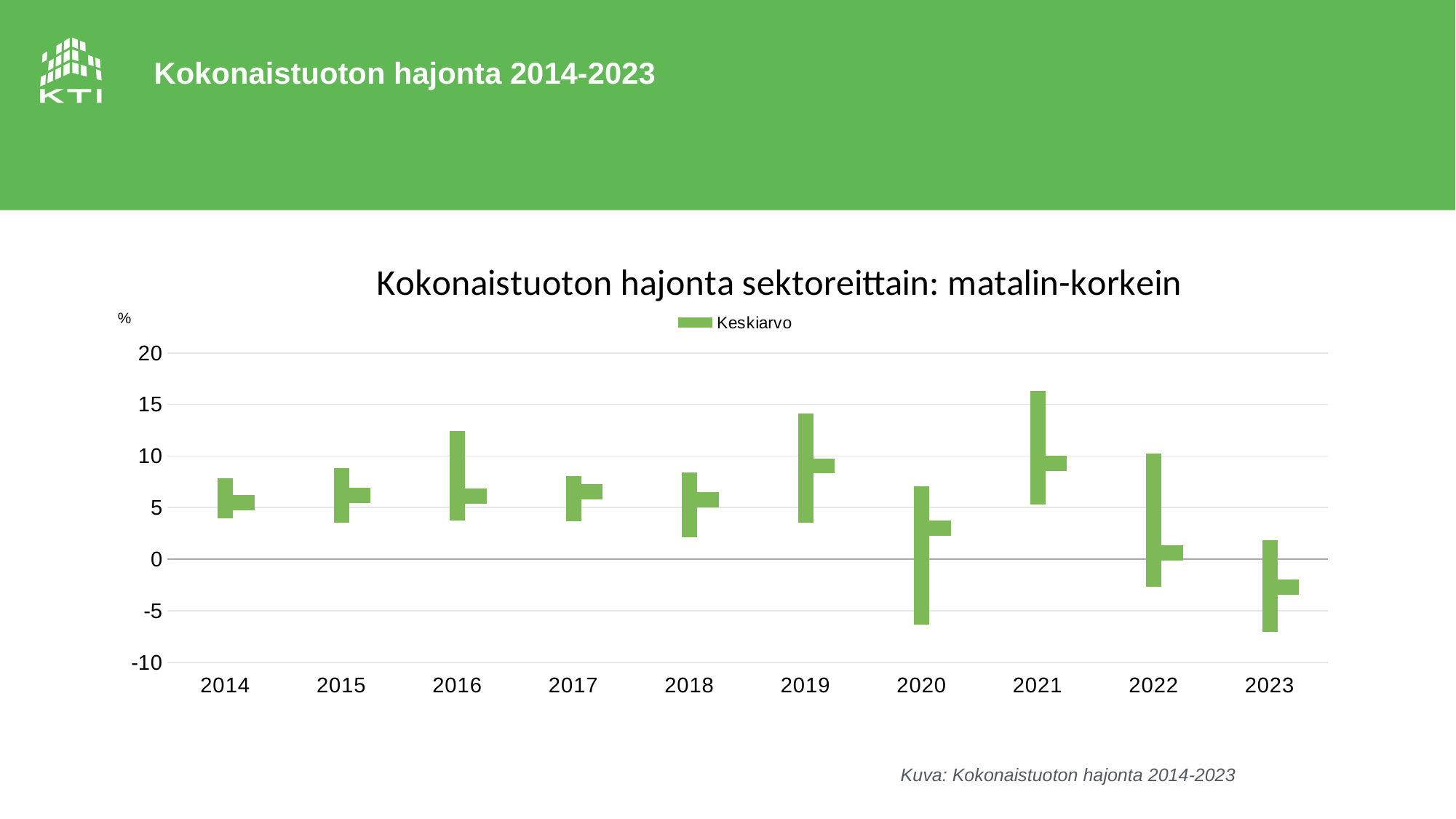
Does the average (Keskiarvo) marker rise or fall from 2021 to 2023? fall Is the upper end of the range for 2021 greater or less than 15? greater Which year has the lowest average (Keskiarvo) marker? 2023 How many years are shown on the x axis of the chart? 10 Is the average (Keskiarvo) marker for 2023 greater or less than 0? less What type of chart is shown on the slide? Bar chart What is the title of the chart? Kokonaistuoton hajonta sektoreittain: matalin-korkein Is the lower end of the range for 2023 greater or less than -5? less How many series does the chart legend list? 1 Which year has the highest upper end of its range bar? 2021 Which year has a higher upper end of its range bar, 2016 or 2017? 2016 What is the legend entry shown in the chart? Keskiarvo